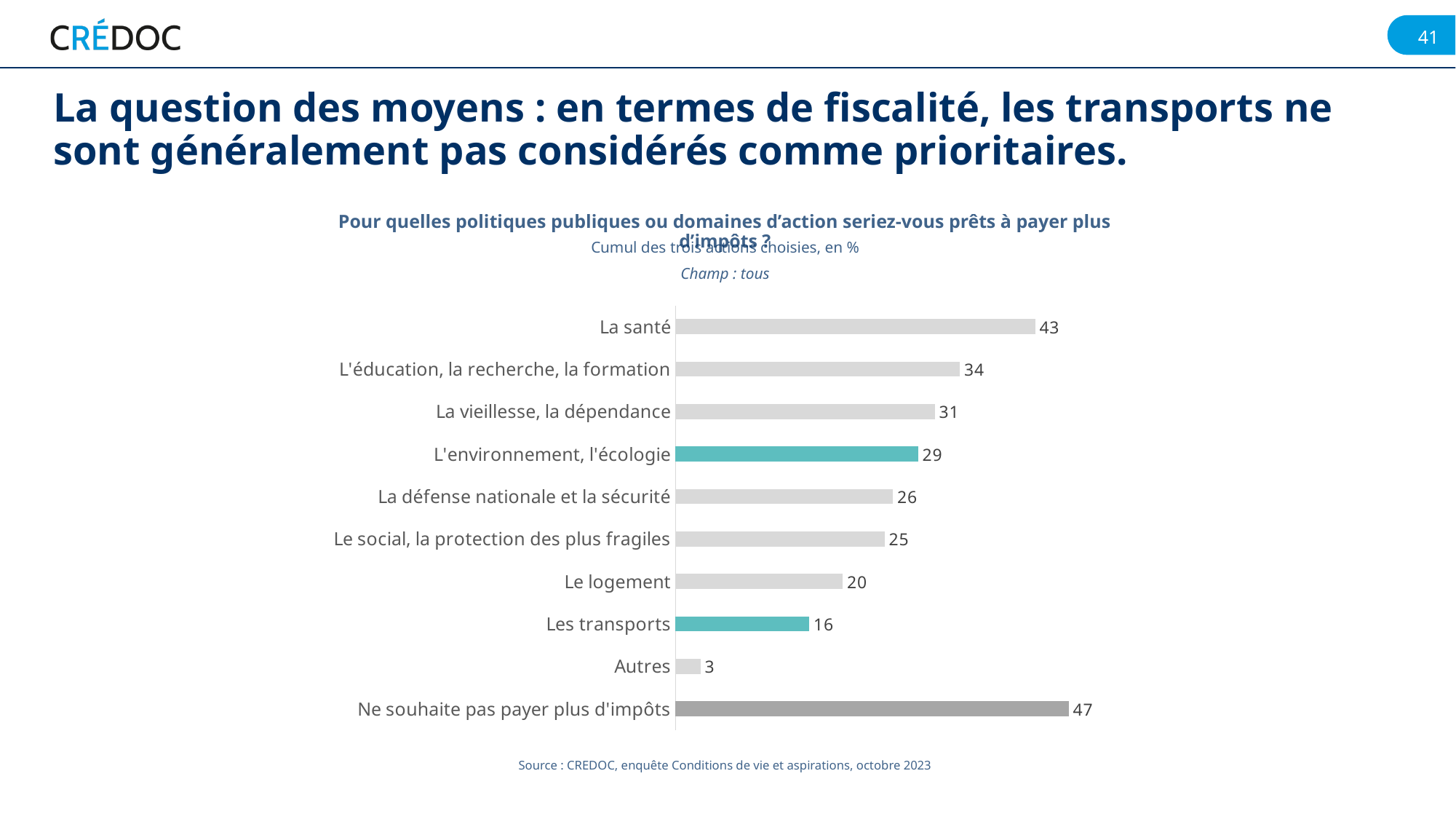
Which category has the highest value? Ne souhaite pas payer plus d'impôts What is the value for La santé? 43 What is the value for Les transports? 16 What is the difference between the values for L'éducation, la recherche, la formation and La vieillesse, la dépendance? 3 What kind of chart is shown on the slide? Bar chart What is the value for Ne souhaite pas payer plus d'impôts? 47 What is the value for L'environnement, l'écologie? 29 How many categories are shown in the chart? 10 What is the difference between the values for La santé and Les transports? 27 Which is larger, the value for Le logement or the value for Le social, la protection des plus fragiles? Le social, la protection des plus fragiles Which category has the lowest value? Autres Which two categories are highlighted in teal in the chart? L'environnement, l'écologie and Les transports